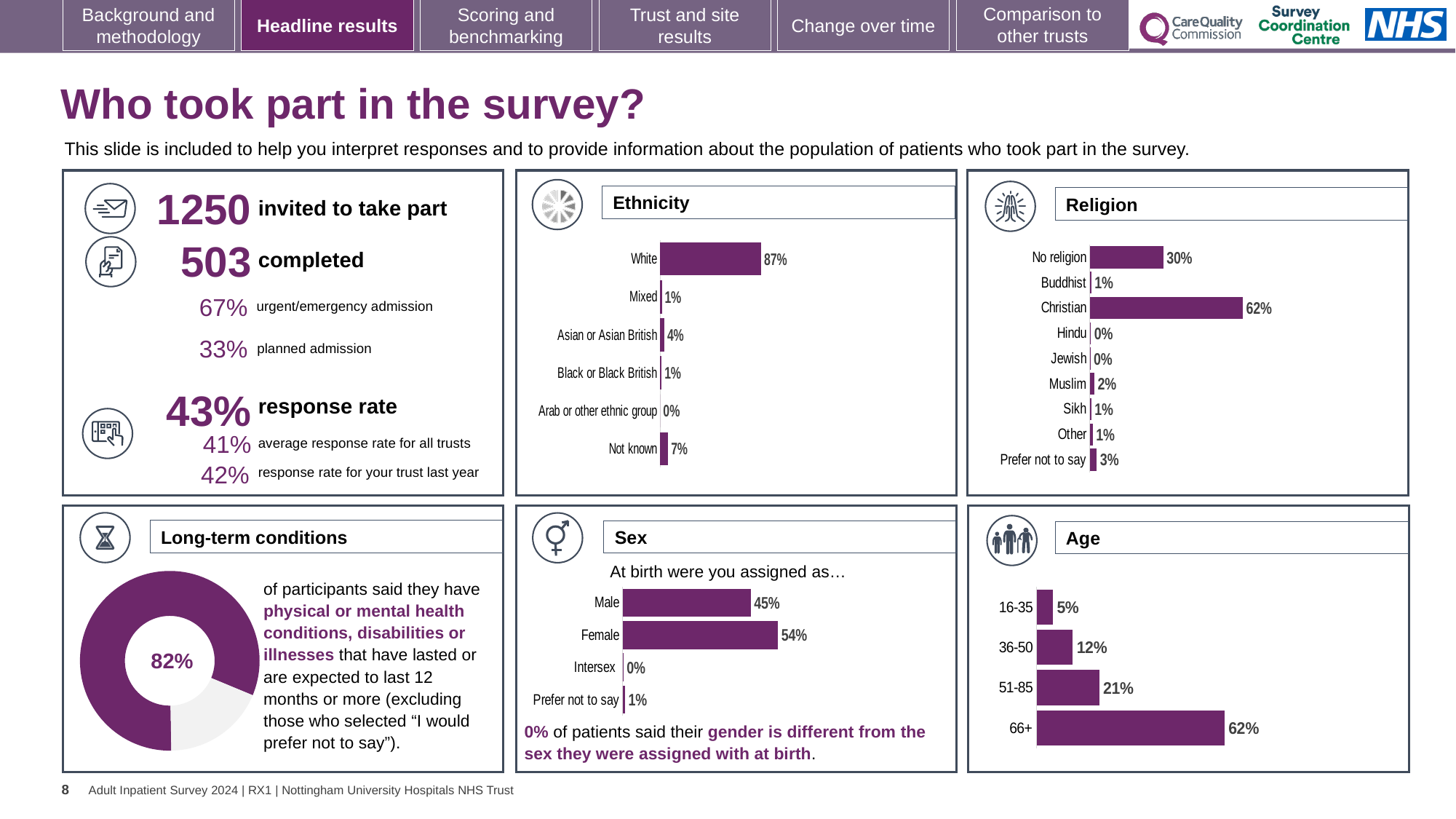
In the Age chart, what is the value for 36-50? 12% In the Ethnicity chart, which category has the highest value? White In the Ethnicity chart, what is the value for Not known? 7% What kind of chart is used in the Long-term conditions panel? Doughnut chart How many categories are shown in the Religion chart? 9 In the Ethnicity chart, what percentage of respondents were White? 87% In the Sex chart, what is the value for Male? 45% In the Sex chart, which is larger, Male or Female? Female In the Age chart, do the values rise or fall from 16-35 to 66+? rise In the Age chart, which age group has the highest value? 66+ In the Religion chart, what percentage of respondents were Christian? 62% In the Religion chart, what is the difference between Christian and No religion? 32%